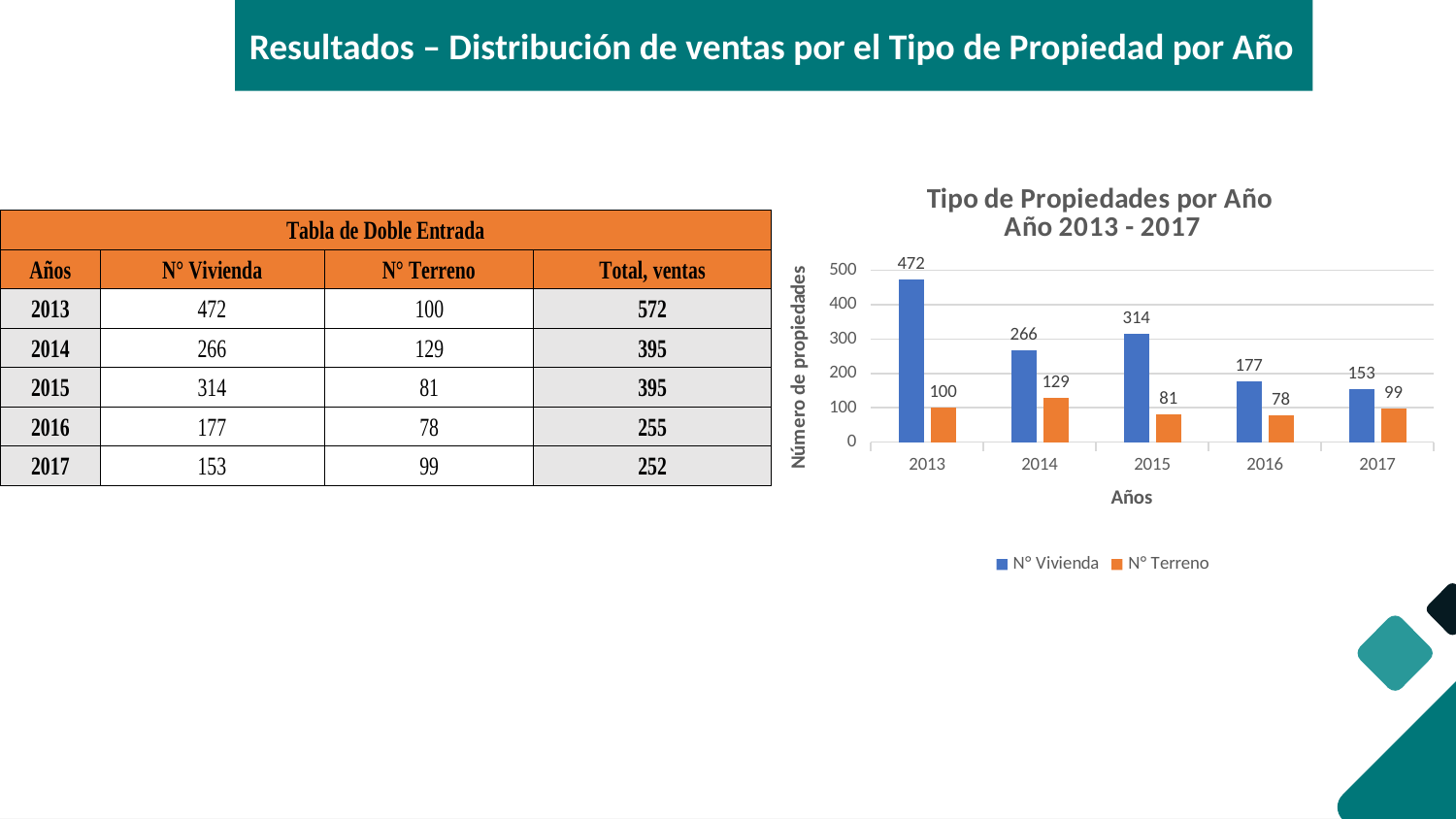
What is the value for N° Terreno in 2014? 129 How many series does the legend list? 2 What is the title of the chart? Tipo de Propiedades por Año Año 2013 - 2017 Which year has the highest value for N° Vivienda? 2013 What is the value for N° Vivienda in 2013? 472 Which year has the lowest value for N° Terreno? 2016 How many years are shown on the x axis? 5 Which is larger in 2017, N° Vivienda or N° Terreno? N° Vivienda What is the difference between N° Vivienda and N° Terreno in 2015? 233 What is the value for N° Terreno in 2016? 78 What kind of chart is shown? bar chart Is the value for N° Vivienda in 2016 greater or less than 200? less